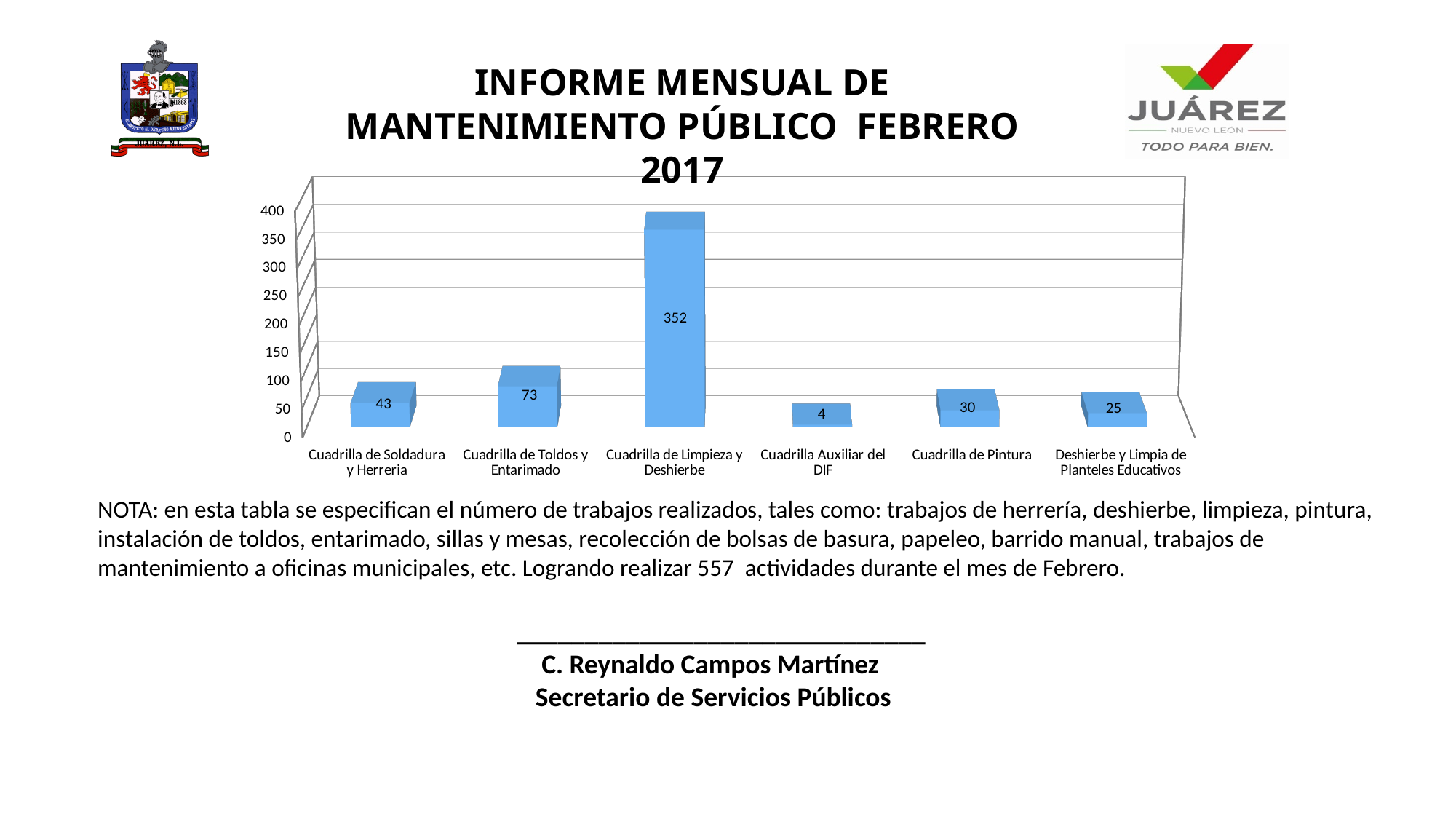
Which category has the lowest value? Cuadrilla Auxiliar del DIF Which category has the highest value? Cuadrilla de Limpieza y Deshierbe What is the value for Cuadrilla de Limpieza y Deshierbe? 352 How many categories are shown on the x axis? 6 What is the value for Cuadrilla de Toldos y Entarimado? 73 What is the value for Deshierbe y Limpia de Planteles Educativos? 25 Which is larger, the value for Cuadrilla de Pintura or the value for Deshierbe y Limpia de Planteles Educativos? Cuadrilla de Pintura What is the difference between the values for Cuadrilla de Toldos y Entarimado and Cuadrilla de Soldadura y Herreria? 30 What is the value for Cuadrilla Auxiliar del DIF? 4 What is the title of the slide above the chart? INFORME MENSUAL DE MANTENIMIENTO PÚBLICO FEBRERO 2017 Is the value for Cuadrilla de Limpieza y Deshierbe greater or less than 300? greater What kind of chart is shown on the slide? bar chart